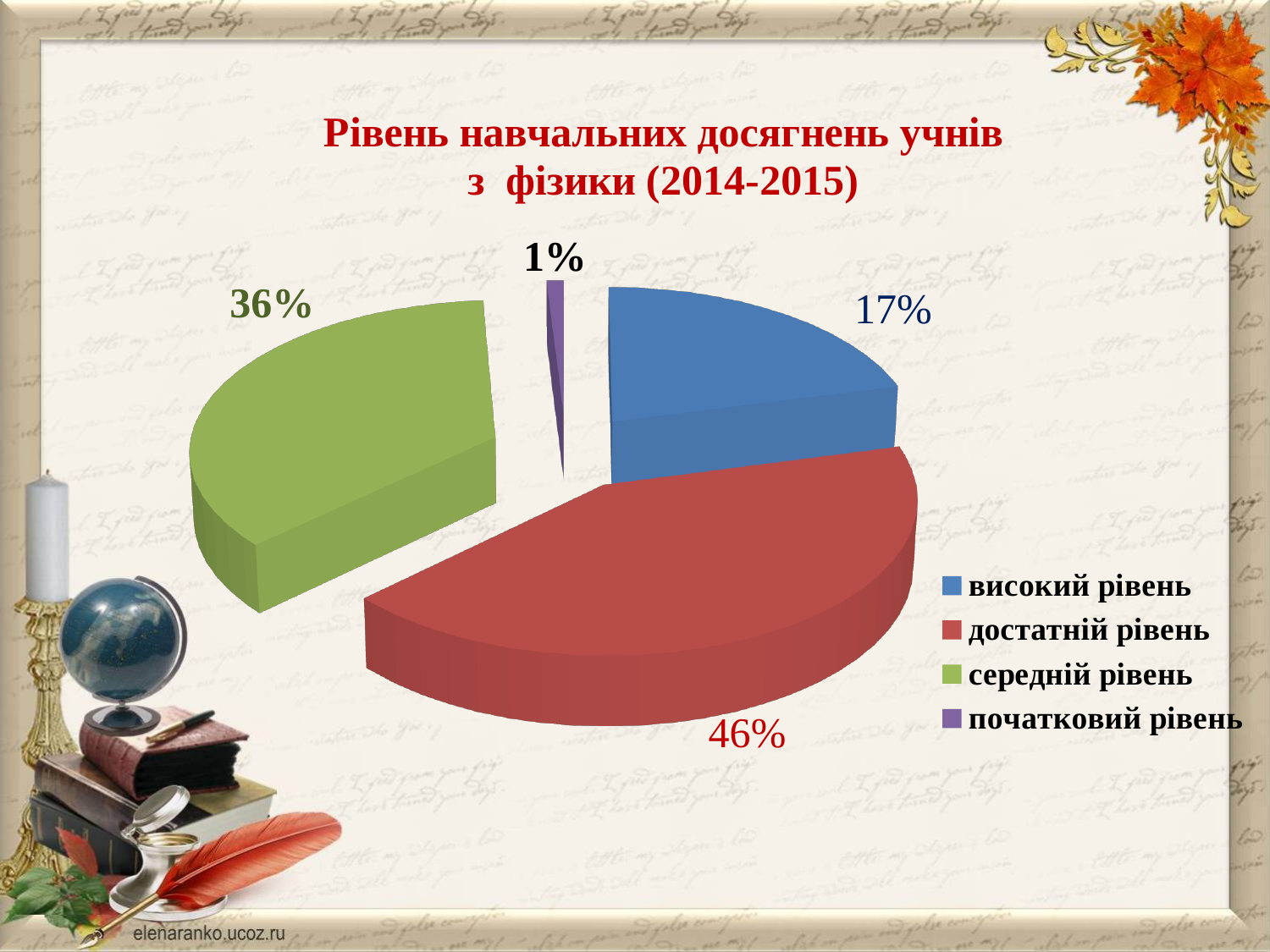
How many categories does the legend list? 4 What colour is the slice for достатній рівень? red What share of the pie is labelled for початковий рівень? 1% What share of the pie is labelled for середній рівень? 36% What is the title of the chart? Рівень навчальних досягнень учнів з фізики (2014-2015) Which category has the smallest slice of the pie? початковий рівень What share of the pie is labelled for високий рівень? 17% Which is larger, the slice for високий рівень or the slice for середній рівень? середній рівень What kind of chart is shown on the slide? pie chart Which category has the largest slice of the pie? достатній рівень What is the difference in percentage points between достатній рівень and середній рівень? 10